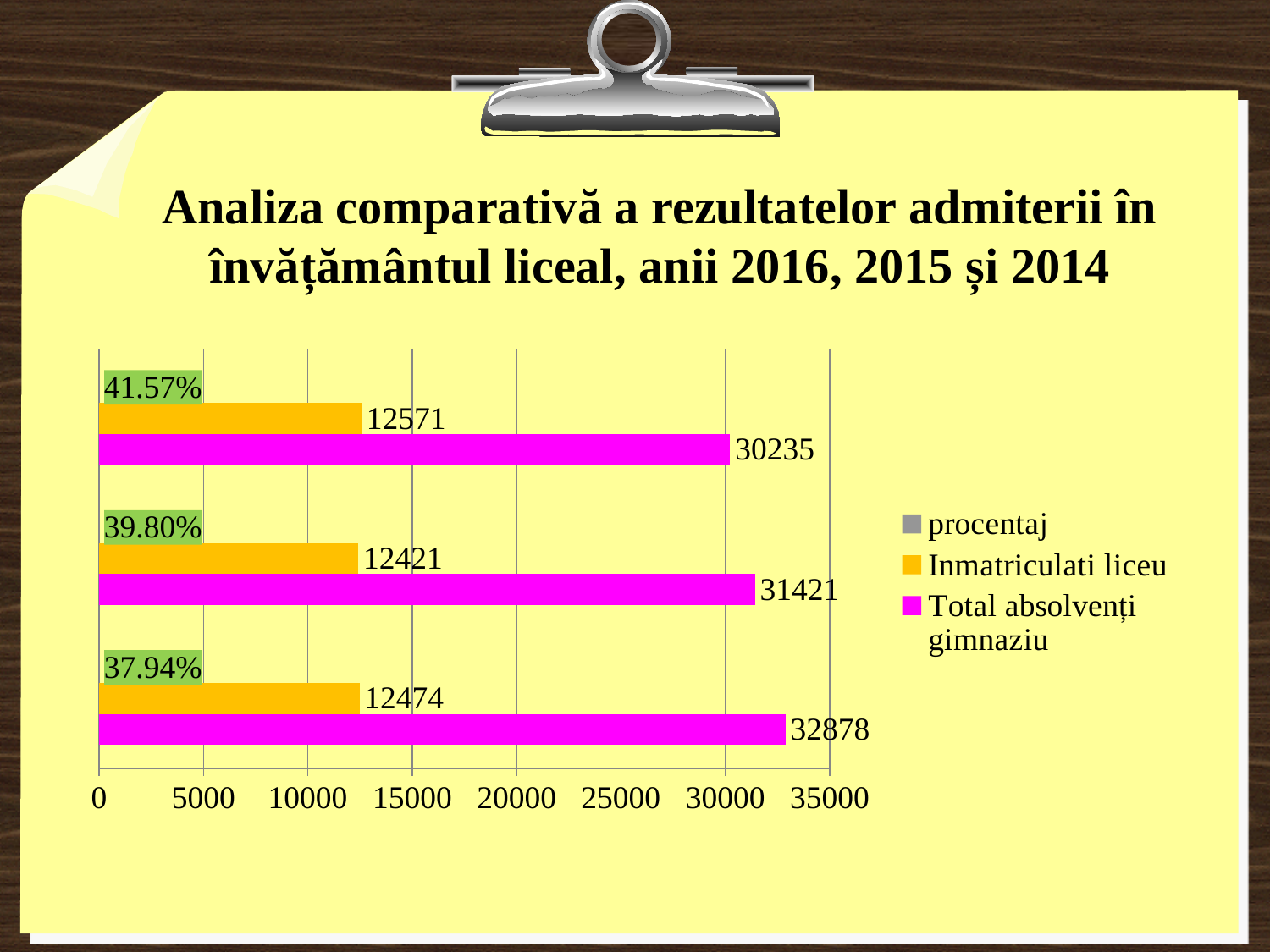
What is the value of the Inmatriculati liceu bar in the bottom group of bars? 12474 Is the Total absolvenți gimnaziu value in the middle group greater or less than 30000? greater What is the difference between the Total absolvenți gimnaziu values of the bottom group and the top group? 2643 Which group of bars has the highest Total absolvenți gimnaziu value? the bottom group What colour are the Total absolvenți gimnaziu bars? magenta Which is larger: the Inmatriculati liceu value in the top group or in the middle group? the top group How many series does the legend list? 3 What is the value of the Total absolvenți gimnaziu bar in the top group of bars? 30235 How many groups of bars are shown in the chart? 3 What kind of chart is shown on the slide? bar chart Which group of bars has the lowest procentaj value? the bottom group What percentage (procentaj) is shown for the middle group of bars? 39.80%